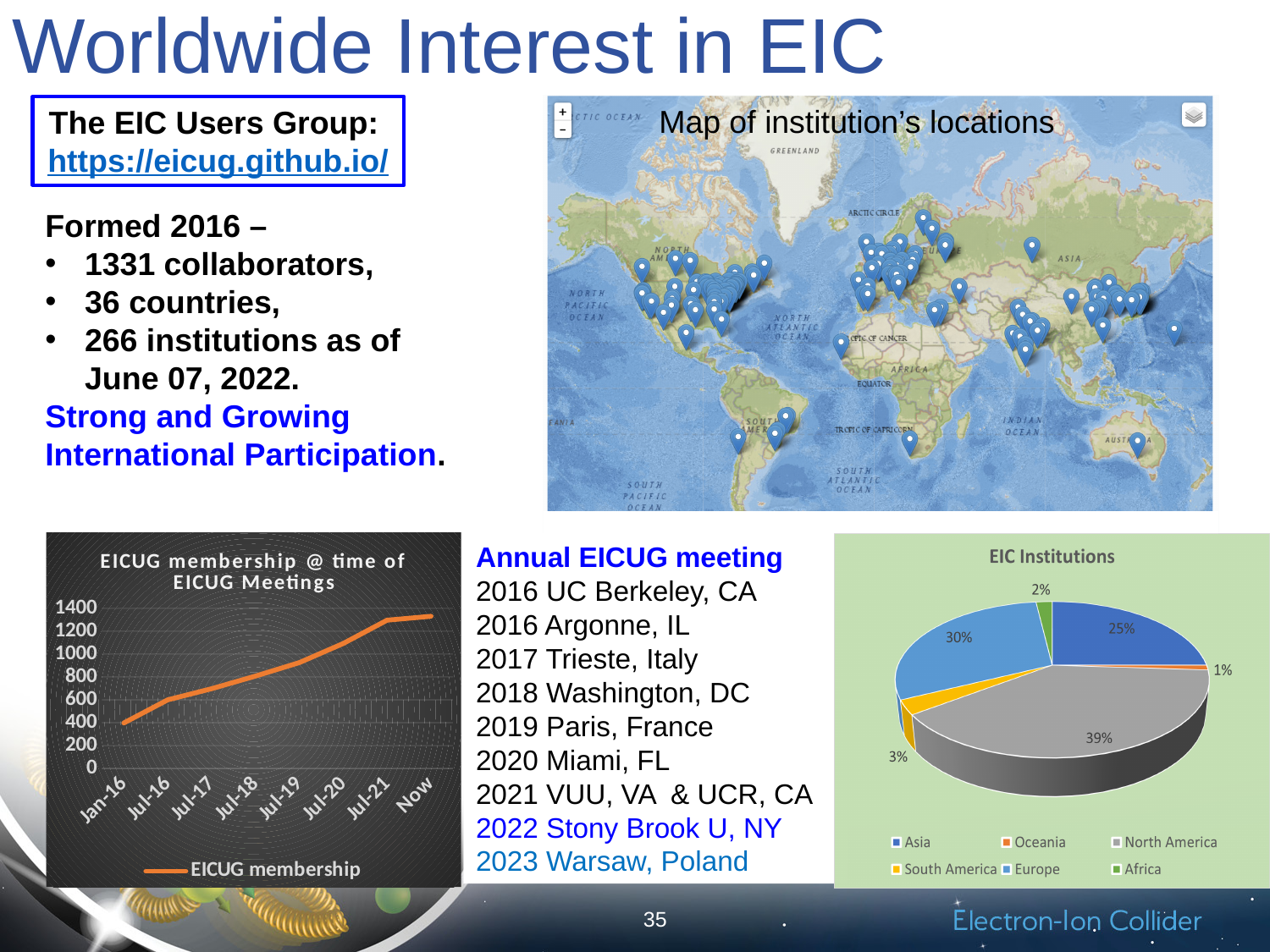
In the EIC Institutions pie chart, what share is shown for Asia? 25% What kind of chart is the EICUG membership @ time of EICUG Meetings chart? Line chart How many series does the legend of the EICUG membership @ time of EICUG Meetings chart list? 1 In the EIC Institutions pie chart, which region has the largest share? North America In the EIC Institutions pie chart, which region has the smallest share? Oceania In the EIC Institutions pie chart, what share is shown for Europe? 30% In the EICUG membership @ time of EICUG Meetings chart, does membership rise or fall from Jan-16 to Now? Rise In the EIC Institutions pie chart, which has the larger share, Asia or Europe? Europe How many regions are listed in the legend of the EIC Institutions pie chart? 6 In the EIC Institutions pie chart, how many percentage points larger is North America's share than Asia's? 14 percentage points In the EICUG membership @ time of EICUG Meetings chart, is the value for Jan-16 greater or less than 600? less In the EIC Institutions pie chart, what share is shown for North America? 39%